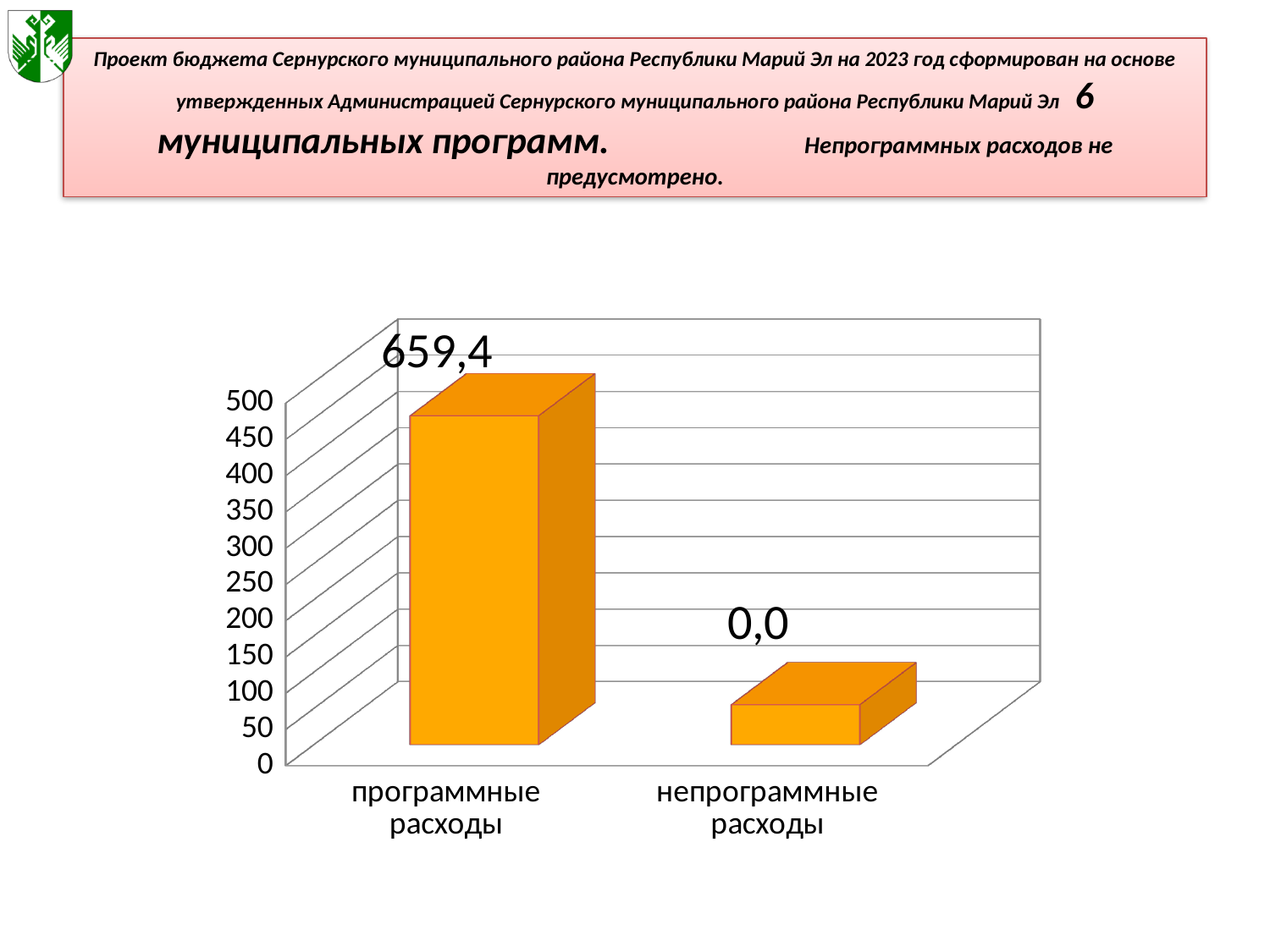
Do the values rise or fall from left to right along the x axis? fall What kind of chart is shown on the slide? bar chart What colour are the bars in the chart? orange Which category has the lowest value? непрограммные расходы What is the highest tick value shown on the vertical axis? 500 Which is larger, the value for программные расходы or the value for непрограммные расходы? программные расходы How many categories are shown on the x axis? 2 What is the difference between the values for программные расходы and непрограммные расходы? 659,4 Which category has the highest value? программные расходы What is the value for непрограммные расходы? 0,0 What is the value for программные расходы? 659,4